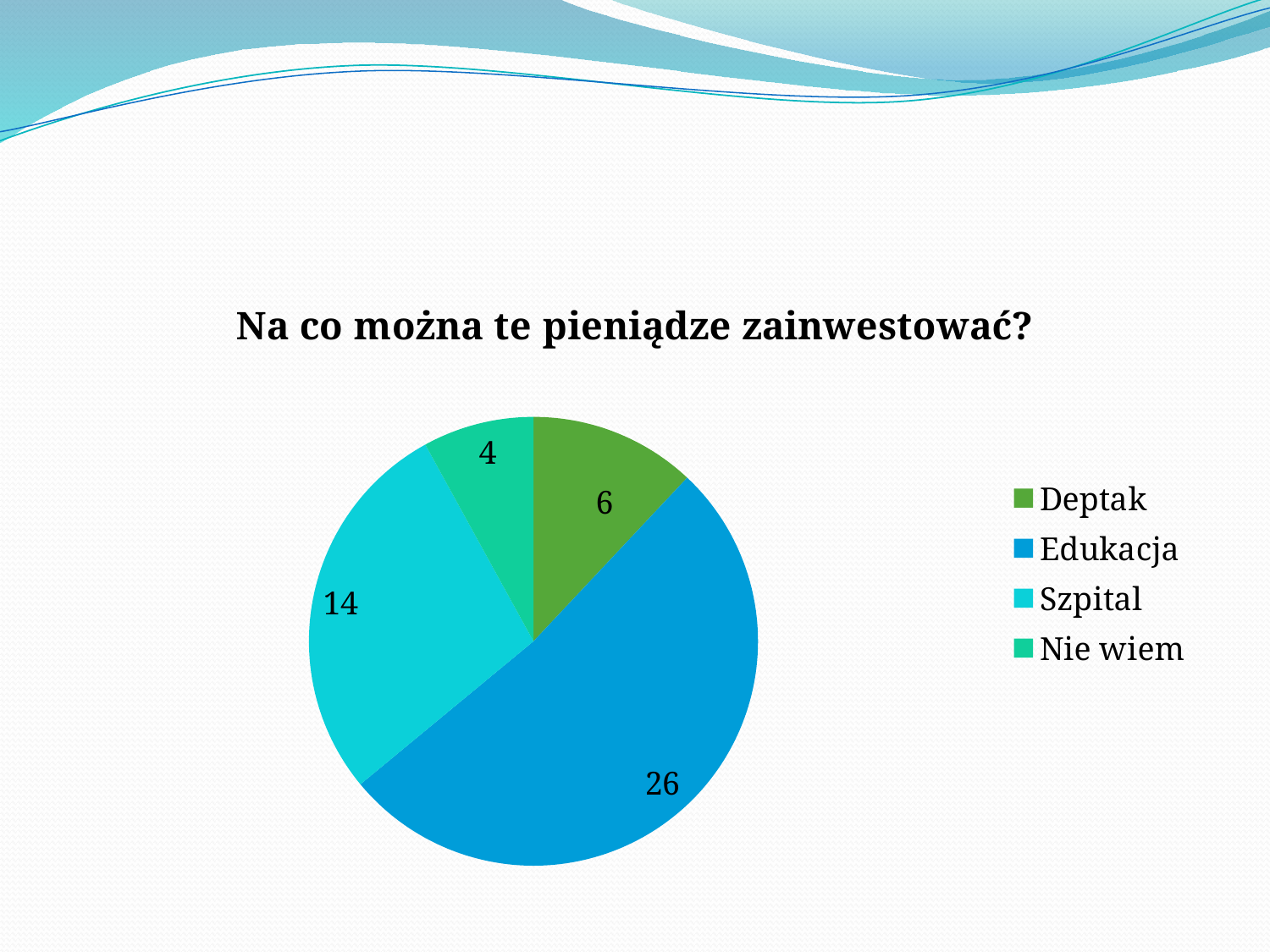
What is the difference between the values for Edukacja and Szpital? 12 What share of the pie does Edukacja represent? 52% What is the value for Szpital? 14 What kind of chart is shown on the slide? pie chart Which is larger, the value for Deptak or the value for Szpital? Szpital What is the value for Deptak? 6 What is the value for Edukacja? 26 How many categories does the pie chart have? 4 Which category has the largest slice? Edukacja What is the value for Nie wiem? 4 Which category has the smallest slice? Nie wiem What is the title of the chart? Na co można te pieniądze zainwestować?